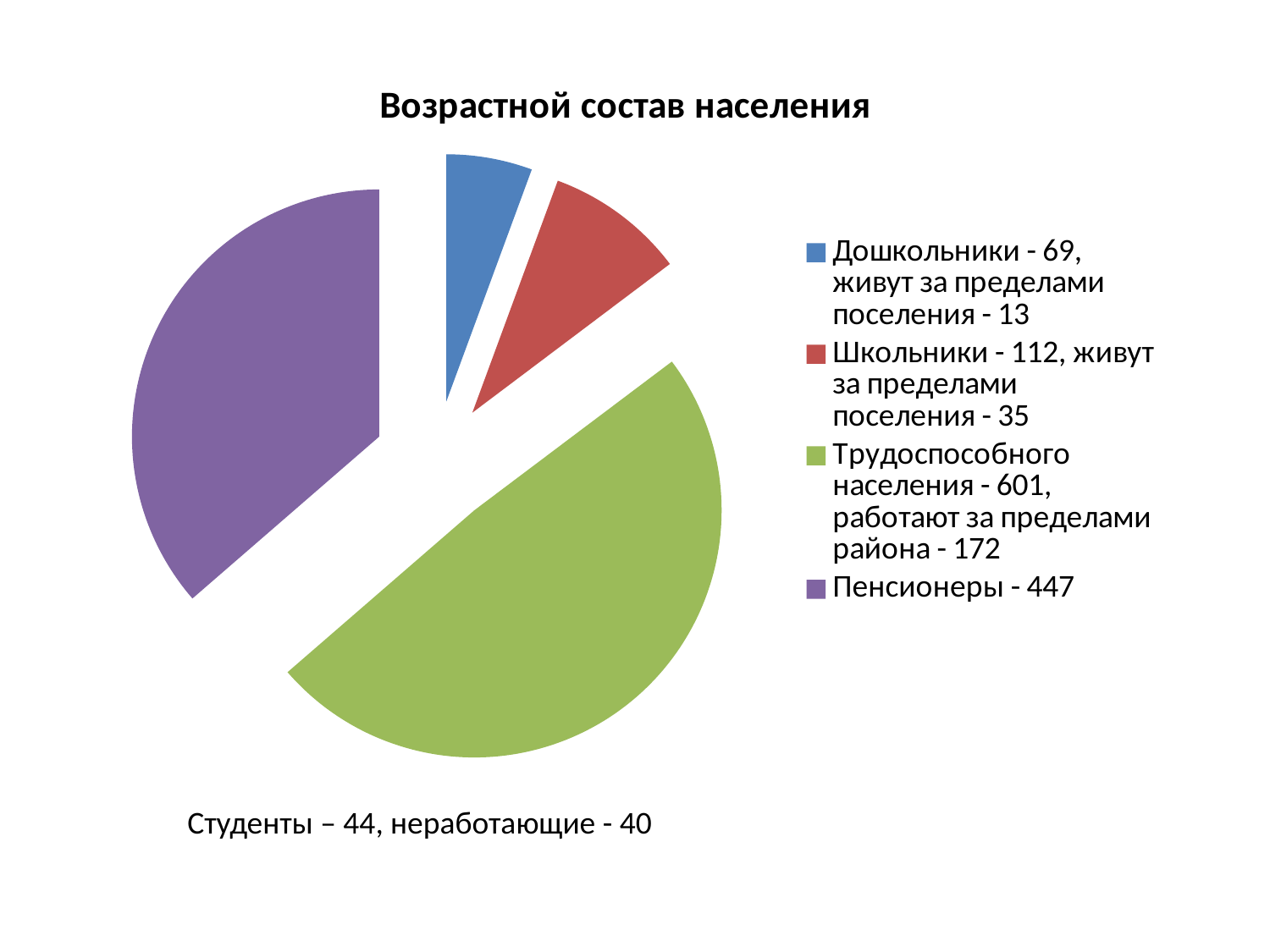
What colour is the slice for Пенсионеры? purple How many slices does the pie chart have? 4 What value is given for Трудоспособного населения in the legend? 601 What is the title of the chart? Возрастной состав населения What value is given for Пенсионеры in the legend? 447 What value is given for Дошкольники in the legend? 69 What value is given for Школьники in the legend? 112 What kind of chart is shown on the slide? pie chart What is the difference between the values for Трудоспособного населения and Пенсионеры? 154 Which category has the smallest slice of the pie? Дошкольники Which is larger, Пенсионеры or Школьники? Пенсионеры Which category has the largest slice of the pie? Трудоспособного населения